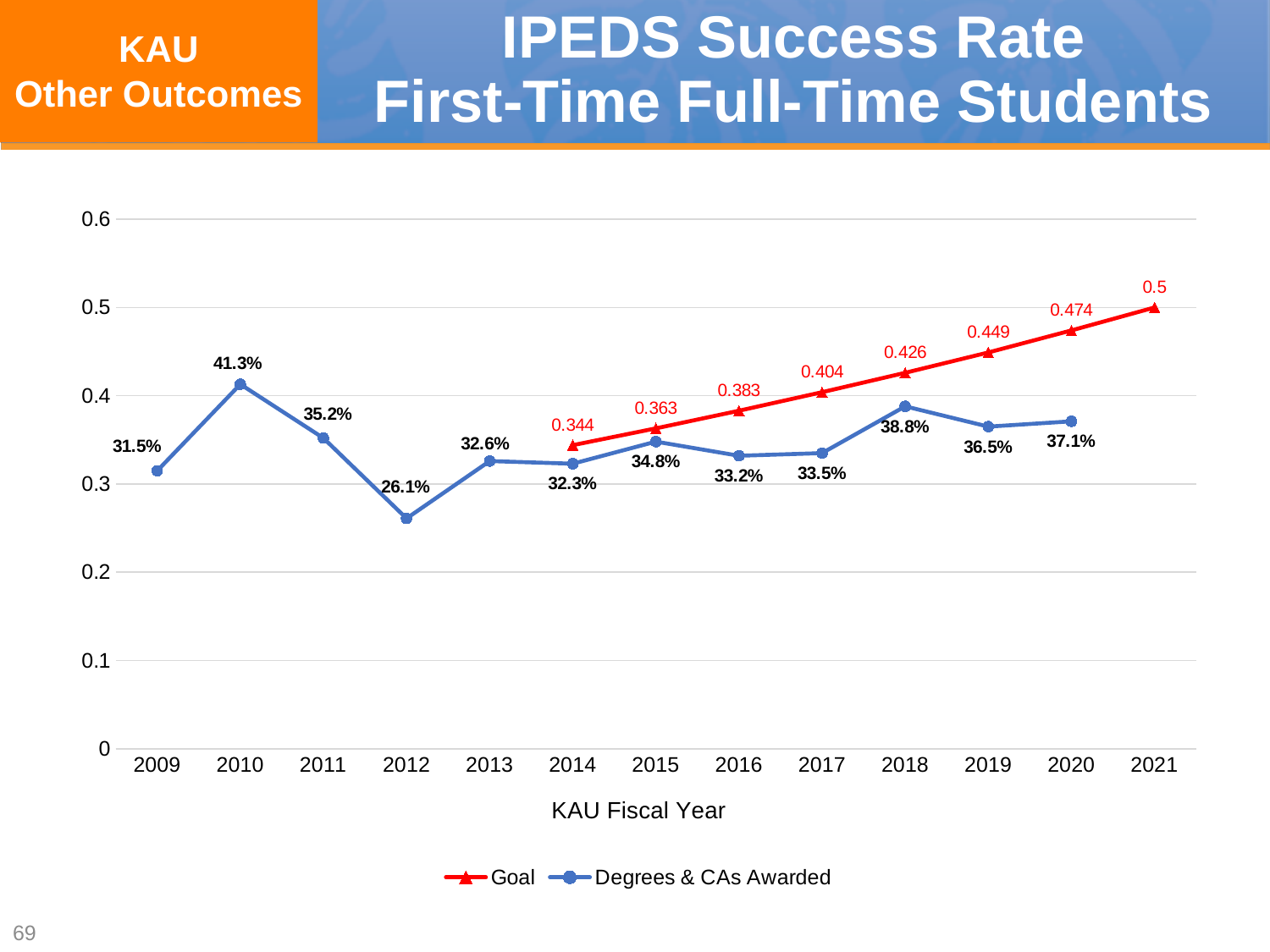
How many series does the legend list? 2 Which is larger in 2018: the Goal value or the Degrees & CAs Awarded value? Goal What is the Goal value for 2017? 0.404 What is the Goal value for 2021? 0.5 Does the Goal series rise or fall from 2014 to 2021? rise What is the Degrees & CAs Awarded value for 2010? 41.3% What is the difference between the Degrees & CAs Awarded values for 2010 and 2012? 15.2% What kind of chart is shown on the slide? line chart In which fiscal year is the Degrees & CAs Awarded value highest? 2010 In which fiscal year is the Degrees & CAs Awarded value lowest? 2012 Is the Degrees & CAs Awarded value for 2012 greater or less than 0.3? less What is the Degrees & CAs Awarded value for 2012? 26.1%